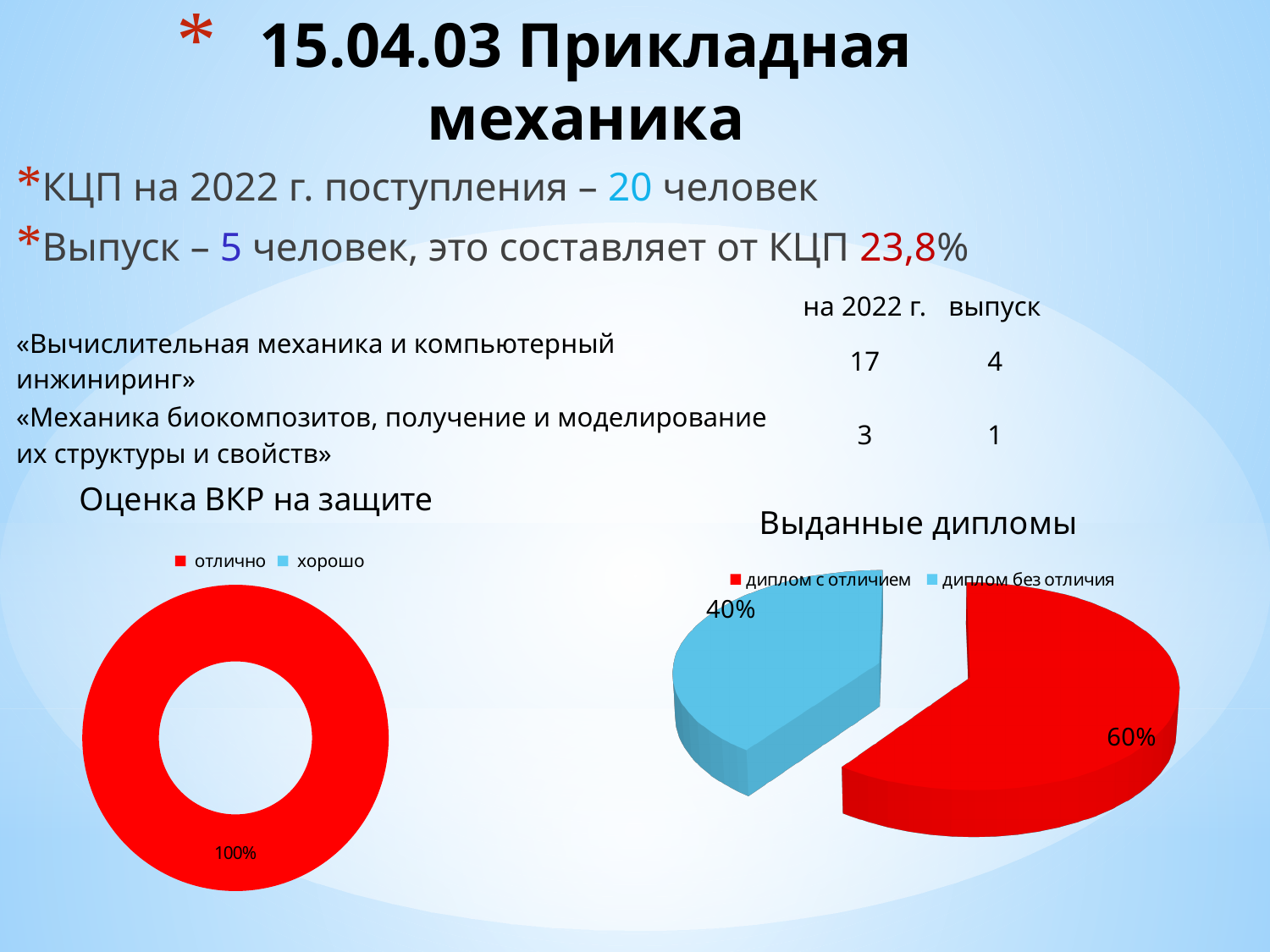
What kind of chart is the one titled «Выданные дипломы»? pie chart In the chart titled «Оценка ВКР на защите», what share is labelled on the red segment? 100% In the chart titled «Выданные дипломы», what share is labelled for «диплом с отличием»? 60% In the chart titled «Выданные дипломы», how many entries does the legend list? 2 In the chart titled «Выданные дипломы», what is the difference in percentage points between «диплом с отличием» and «диплом без отличия»? 20 In the chart titled «Выданные дипломы», what share is labelled for «диплом без отличия»? 40% What kind of chart is the one titled «Оценка ВКР на защите»? doughnut chart In the chart titled «Выданные дипломы», which colour represents «диплом без отличия»? blue In the chart titled «Выданные дипломы», which category has the larger share? диплом с отличием In the chart titled «Оценка ВКР на защите», how many entries does the legend list? 2 In the chart titled «Выданные дипломы», which category has the smaller share? диплом без отличия In the chart titled «Оценка ВКР на защите», which legend entry corresponds to the red colour? отлично